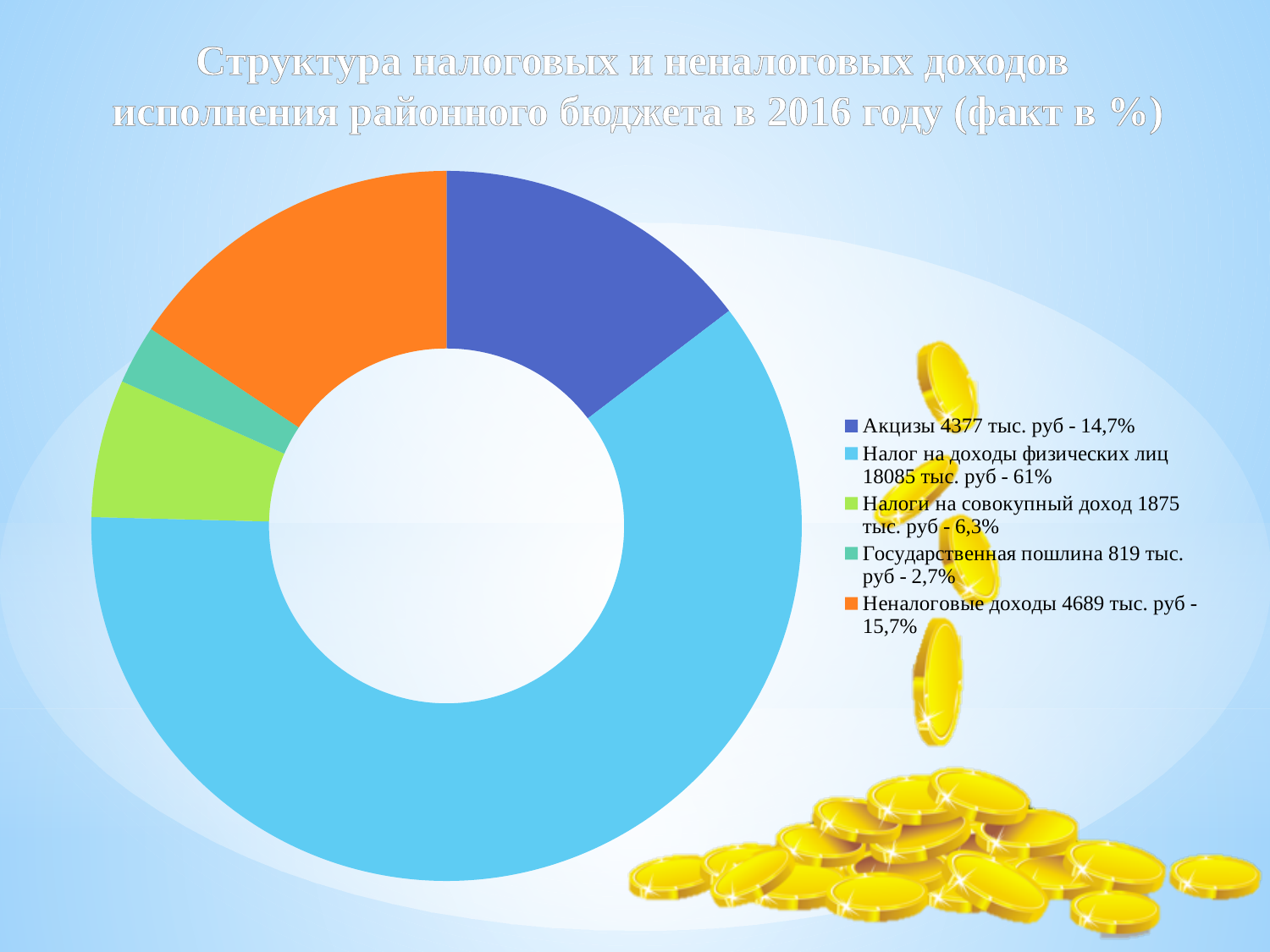
Which category has the smallest share? Государственная пошлина What is the value in тыс. руб for Государственная пошлина? 819 тыс. руб What is the difference in percentage points between Неналоговые доходы (15,7%) and Акцизы (14,7%)? 1 percentage point Which category has the largest share? Налог на доходы физических лиц Which is larger: Неналоговые доходы or Акцизы? Неналоговые доходы What colour represents Неналоговые доходы in the chart? Orange What is the value in тыс. руб for Акцизы? 4377 тыс. руб What share of the total does Налог на доходы физических лиц account for? 61% What is the difference in тыс. руб between Налоги на совокупный доход and Государственная пошлина? 1056 тыс. руб What percentage is shown for Неналоговые доходы? 15,7% What kind of chart is shown on the slide? Doughnut (pie) chart How many categories does the chart show? 5